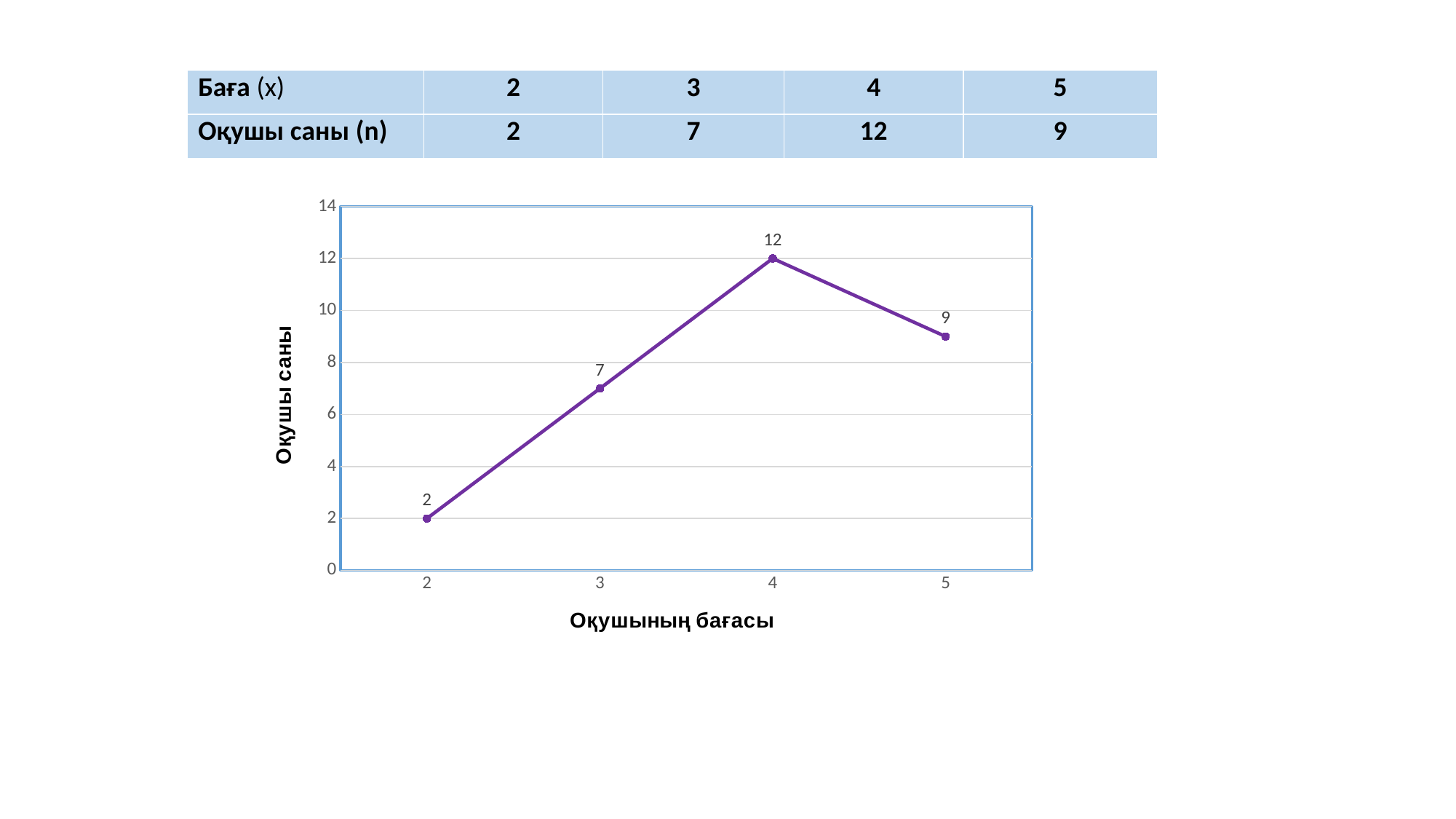
What is the number of students for grade 5? 9 Which has more students: grade 3 or grade 5? 5 How many data points are plotted on the chart? 4 What is the label of the x axis? Оқушының бағасы What is the number of students (Оқушы саны) for grade 4? 12 What type of chart is shown on the slide? line chart Is the value for grade 3 greater or less than 6? greater What is the difference between the number of students for grade 4 and grade 3? 5 What is the number of students for grade 2? 2 Which grade has the highest number of students? 4 Does the number of students rise or fall from grade 4 to grade 5? fall Which grade has the lowest number of students? 2